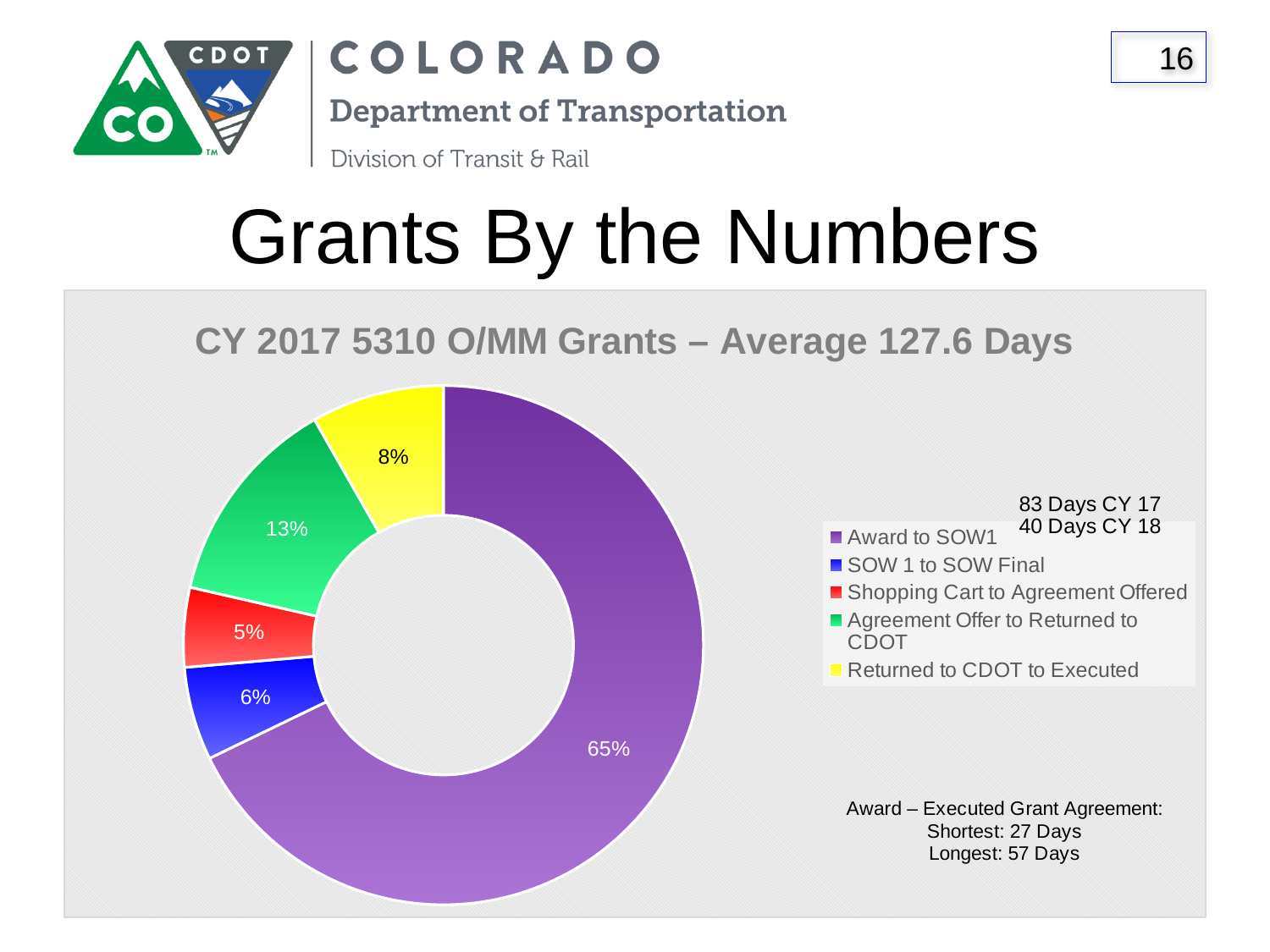
What percentage share does the SOW 1 to SOW Final slice have? 6% What is the title of the chart? CY 2017 5310 O/MM Grants – Average 127.6 Days What percentage share does the Shopping Cart to Agreement Offered slice have? 5% Which category has the largest share of the chart? Award to SOW1 How many categories does the legend list? 5 What is the difference in percentage points between the Agreement Offer to Returned to CDOT slice and the Returned to CDOT to Executed slice? 5 percentage points Which slice is larger, SOW 1 to SOW Final or Returned to CDOT to Executed? Returned to CDOT to Executed What percentage share does the Agreement Offer to Returned to CDOT slice have? 13% What percentage share does the Award to SOW1 slice have? 65% What percentage share does the Returned to CDOT to Executed slice have? 8% What kind of chart is shown on the slide? Doughnut (pie) chart Which category has the smallest share of the chart? Shopping Cart to Agreement Offered